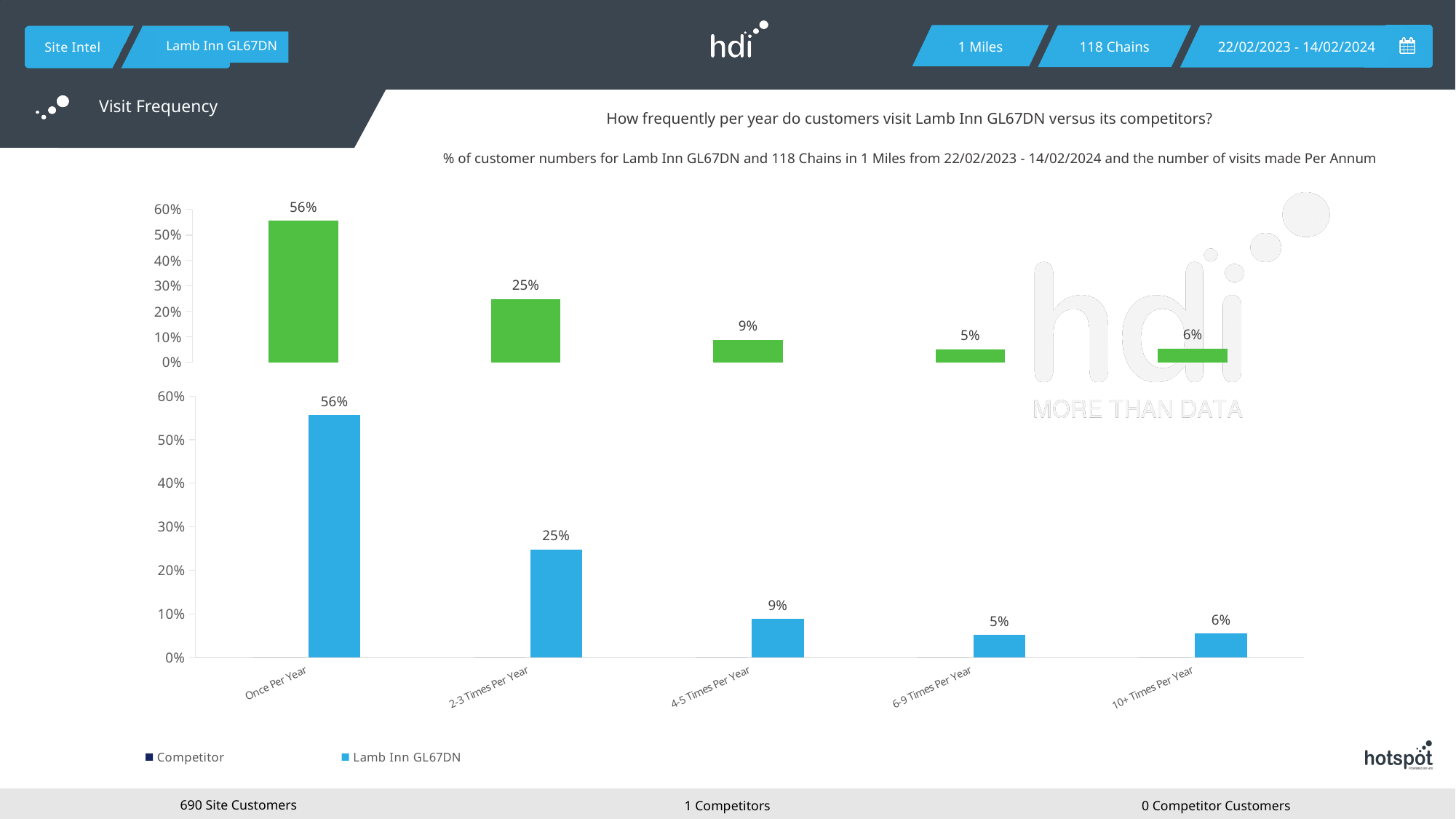
On the bottom chart, what is the value for 10+ Times Per Year? 6% What kind of chart is the bottom chart? bar chart How many categories are shown on the x axis of the bottom chart? 5 On the bottom chart, which category has the lowest value? 6-9 Times Per Year How many series does the legend of the bottom chart list? 2 On the bottom chart, which category has the highest value? Once Per Year On the bottom chart, what is the value for 2-3 Times Per Year? 25% On the bottom chart, what is the value for Once Per Year? 56% On the bottom chart, what is the value for 4-5 Times Per Year? 9% On the bottom chart, what is the difference between the values for Once Per Year and 2-3 Times Per Year? 31% On the top chart, what is the value shown on the first (leftmost) bar? 56% On the bottom chart, which is larger: the value for 6-9 Times Per Year or 10+ Times Per Year? 10+ Times Per Year